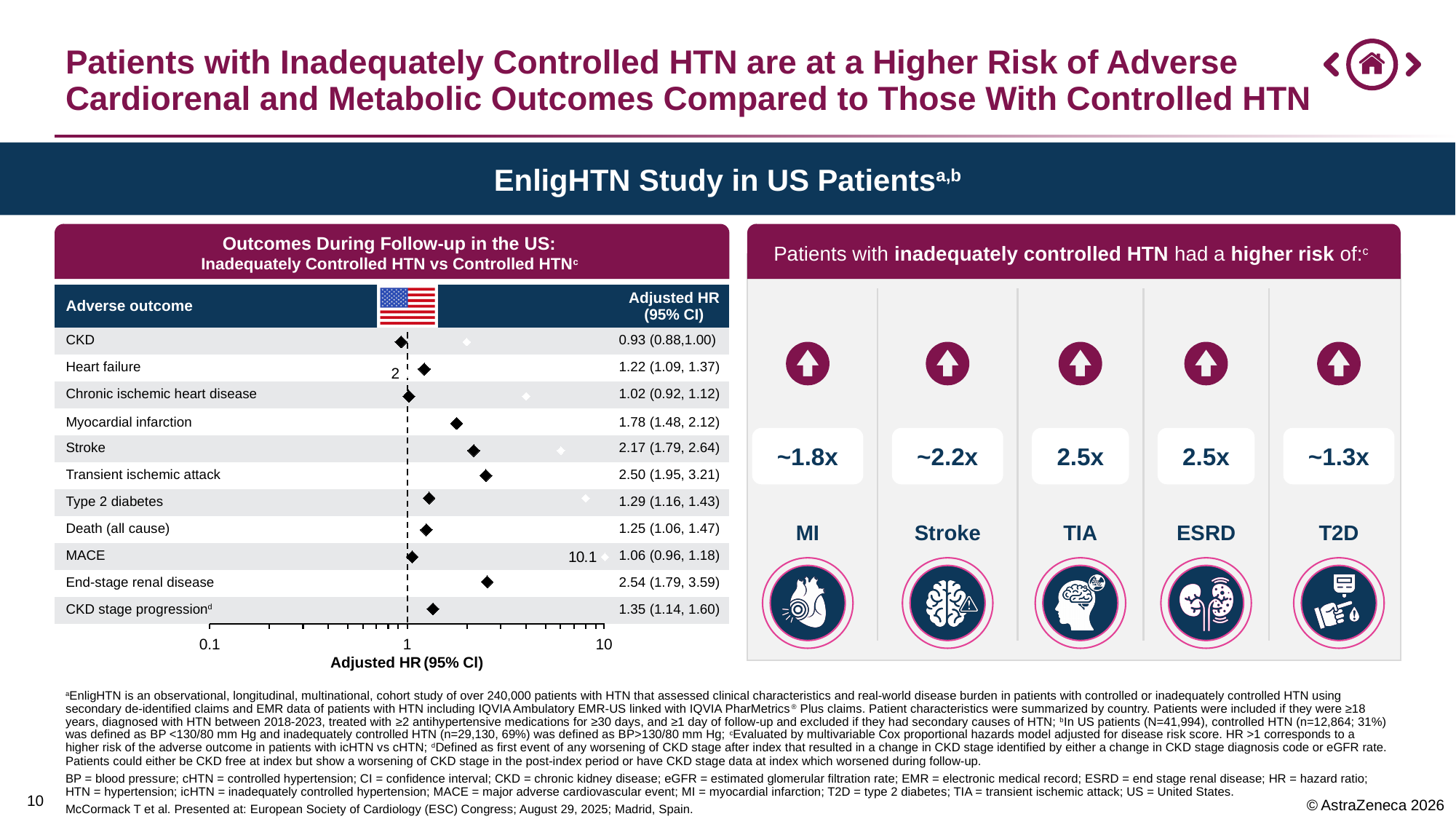
Which adverse outcome has the lowest adjusted HR? CKD What is the adjusted HR for myocardial infarction? 1.78 What is the 95% CI for transient ischemic attack? (1.95, 3.21) What kind of chart is used to show the adjusted HRs? Forest plot Is the adjusted HR for MACE greater or less than 1? greater Which has a larger adjusted HR, heart failure or type 2 diabetes? Type 2 diabetes How many adverse outcomes are listed in the forest plot? 11 What is the adjusted HR and 95% CI for end-stage renal disease? 2.54 (1.79, 3.59) What is the label of the x axis of the forest plot? Adjusted HR (95% CI) What is the difference between the adjusted HR for stroke and the adjusted HR for myocardial infarction? 0.39 Which adverse outcome has the highest adjusted HR? End-stage renal disease What is the adjusted HR for stroke in the forest plot? 2.17